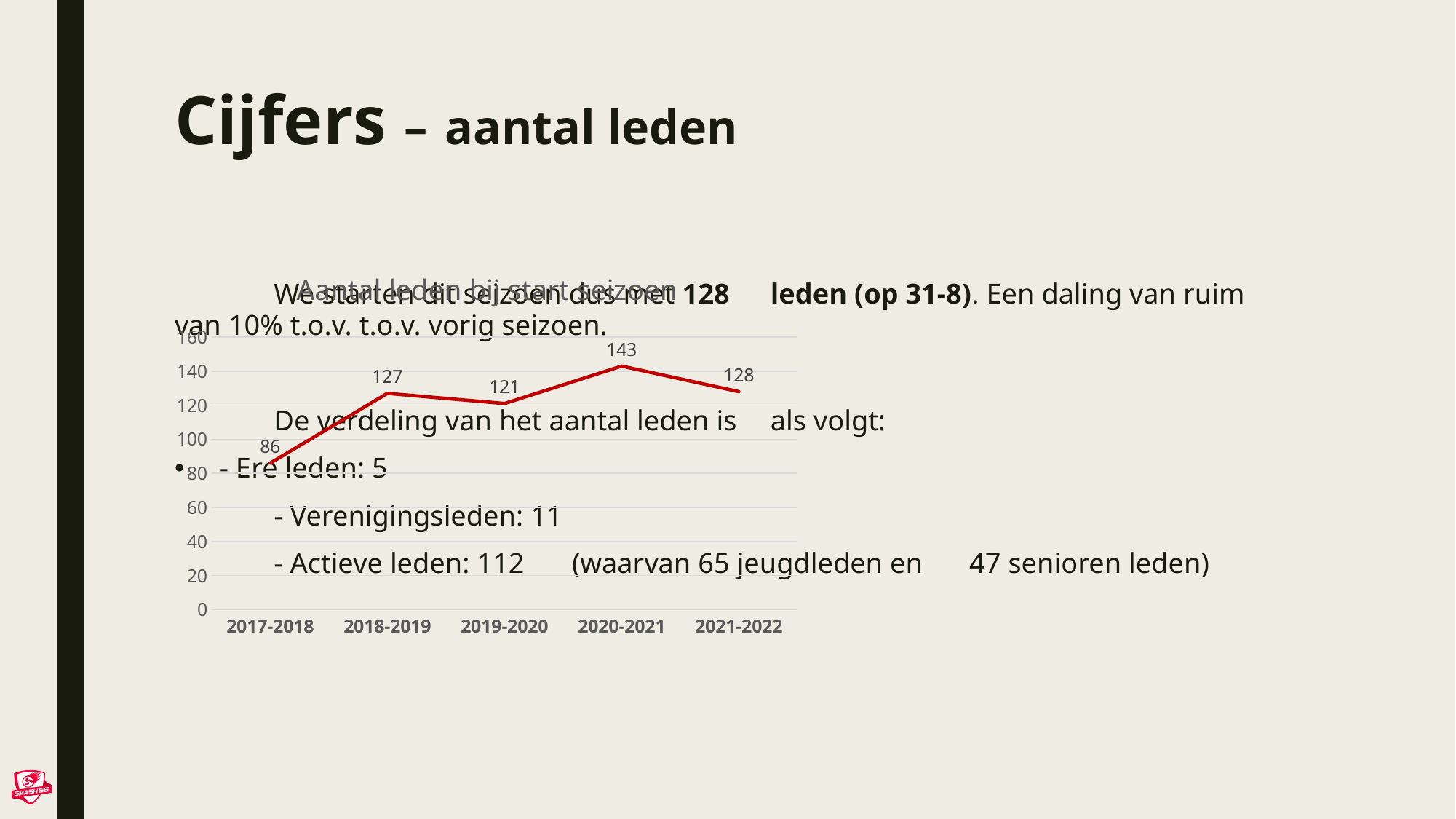
What is the value for 2020-2021? 143 Which season has the lowest value? 2017-2018 Which is larger, the value for 2018-2019 or the value for 2019-2020? 2018-2019 How many seasons are plotted on the chart? 5 What is the value for 2021-2022? 128 What kind of chart is shown on the slide? line chart What is the difference between the values for 2020-2021 and 2021-2022? 15 What is the difference between the values for 2018-2019 and 2017-2018? 41 Does the value rise or fall from 2020-2021 to 2021-2022? fall What is the value for 2017-2018? 86 Which season has the highest value? 2020-2021 Is the value for 2017-2018 greater or less than 100? less